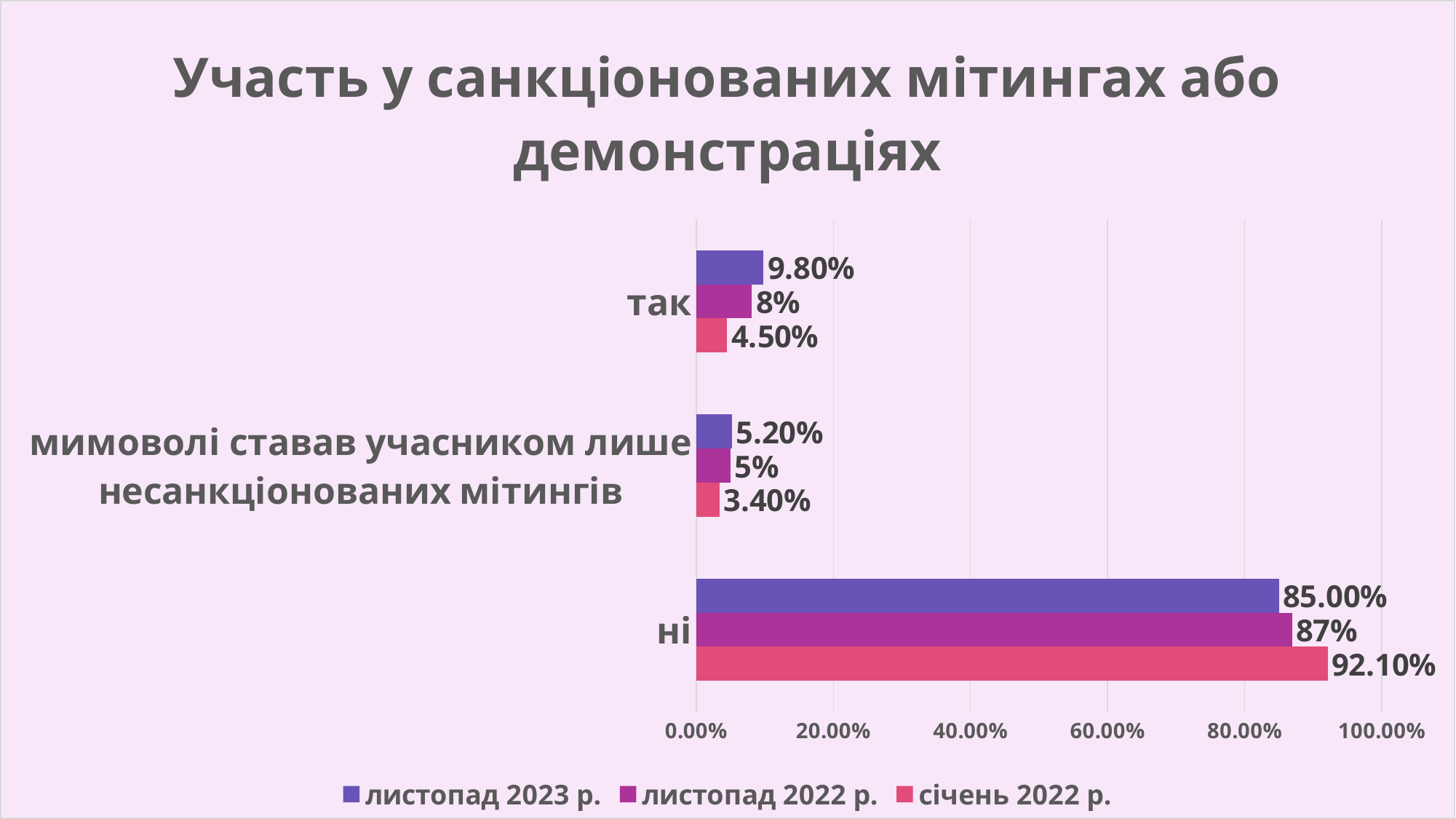
For "так", which series has the larger value: "листопад 2023 р." or "січень 2022 р."? листопад 2023 р. What is the value for "так" in the "січень 2022 р." series? 4.50% What is the value for "так" in the "листопад 2023 р." series? 9.80% How many categories are shown on the chart? 3 What is the value for "мимоволі ставав учасником лише несанкціонованих мітингів" in the "листопад 2022 р." series? 5% Which category has the lowest value in the "січень 2022 р." series? мимоволі ставав учасником лише несанкціонованих мітингів Which category has the highest value in the "листопад 2023 р." series? ні What is the value for "ні" in the "січень 2022 р." series? 92.10% Is the value for "ні" in the "листопад 2022 р." series greater or less than 80.00%? greater What kind of chart is shown on the slide? bar chart What is the difference between the "січень 2022 р." and "листопад 2023 р." values for "ні"? 7.10% How many series does the legend list? 3